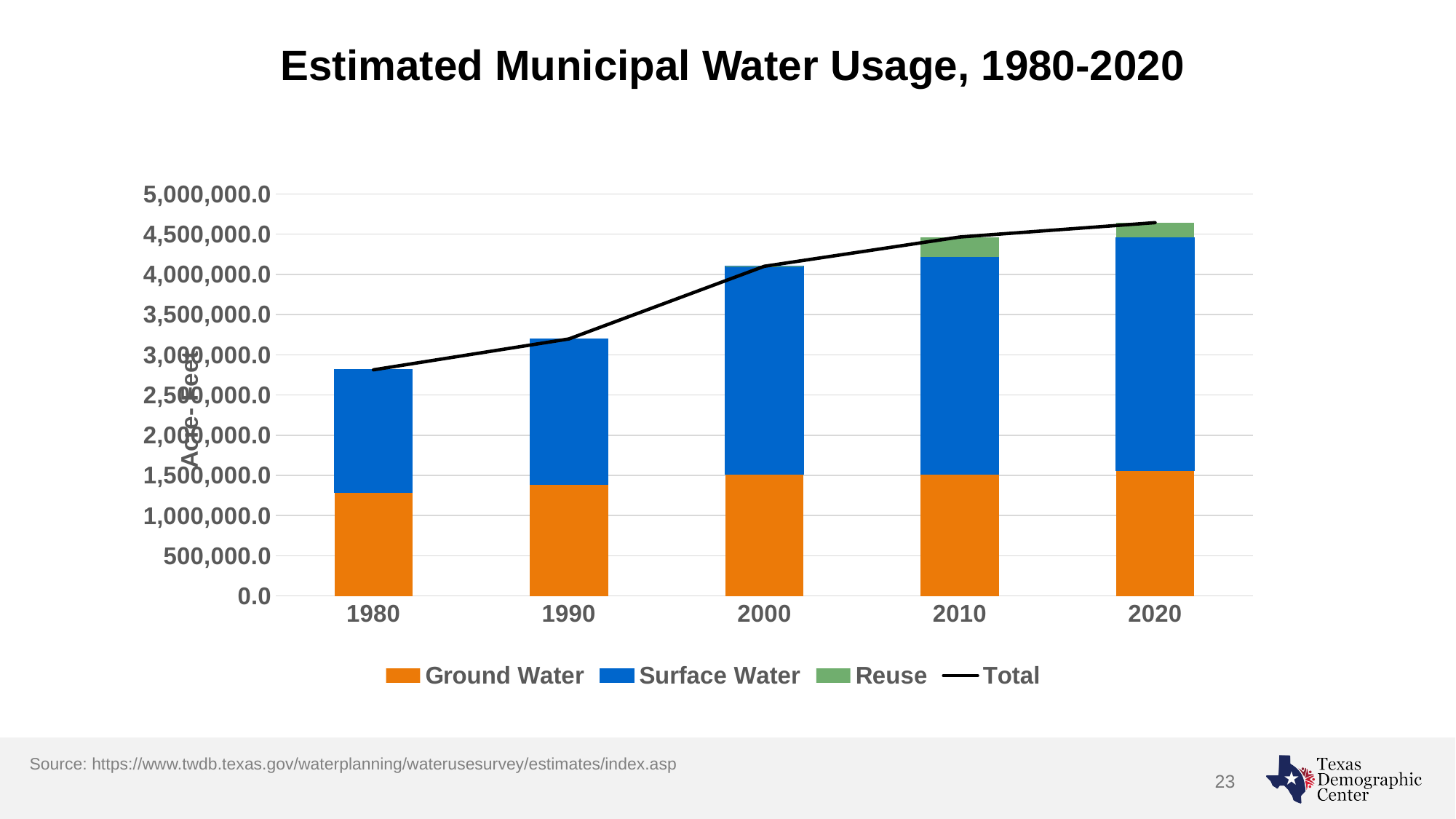
What kind of chart is shown on the slide? Stacked bar chart with a line Which year has the highest total municipal water usage? 2020 Which year has the lowest total municipal water usage? 1980 Is the total water usage for 2000 greater or less than 4,000,000.0? greater How many series does the legend list? 4 Is the Ground Water value for 1980 greater or less than 1,500,000.0? less Is the total water usage for 2020 greater or less than 4,500,000.0? greater How many years are shown on the x axis? 5 Which year has the larger total water usage, 1990 or 2000? 2000 Which colour represents Surface Water in the chart? Blue Does the Total line rise or fall from 1980 to 2020? Rises